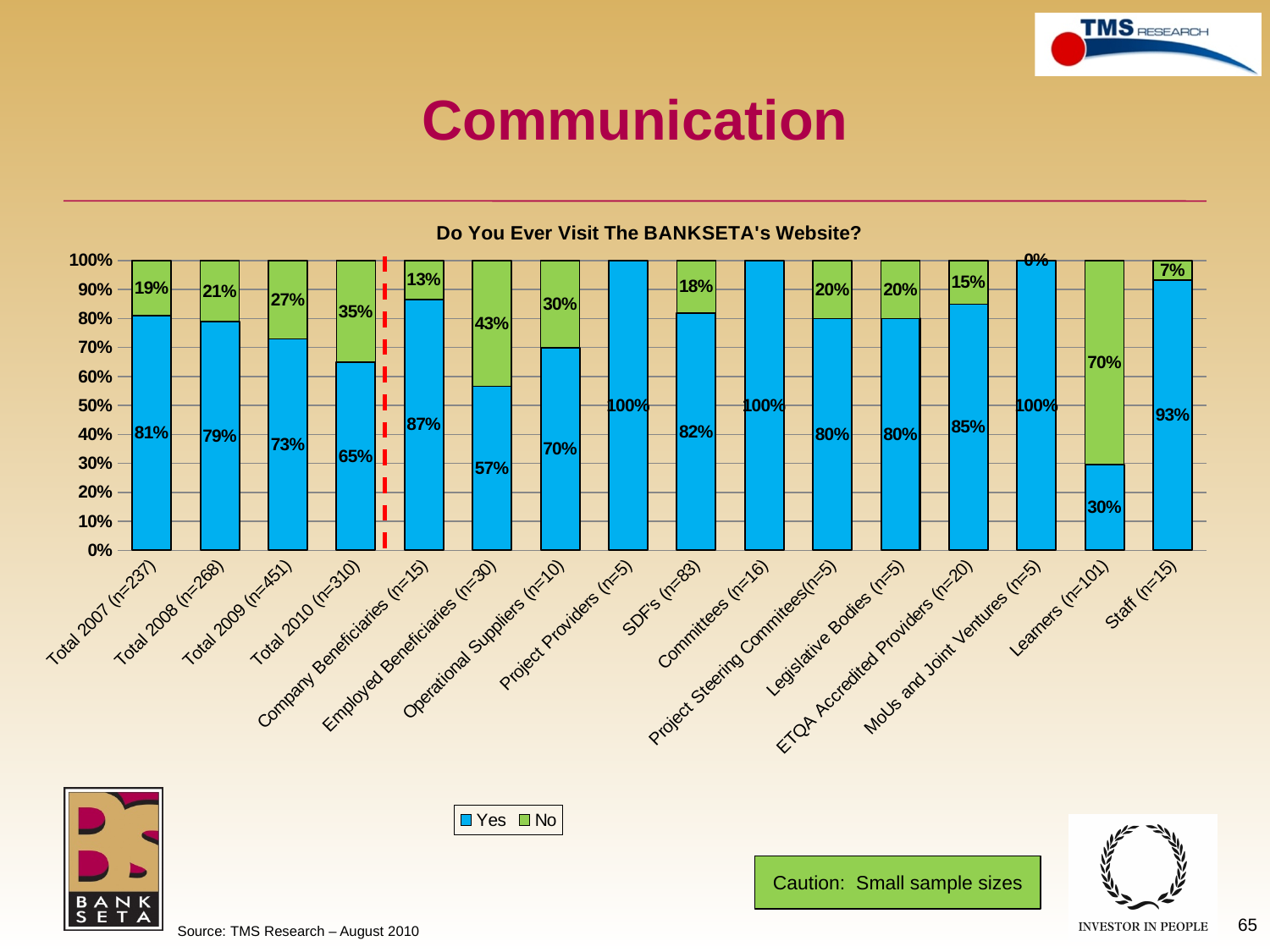
Does the Yes percentage rise or fall across the Total 2007 to Total 2010 categories? Fall What is the Yes percentage for Staff (n=15)? 93% What is the title of the chart? Do You Ever Visit The BANKSETA's Website? What percentage of Learners (n=101) answered Yes to visiting the BANKSETA website? 30% How many categories are shown on the x axis of the chart? 16 How many series does the legend list? 2 What is the No percentage for Total 2010 (n=310)? 35% What is the difference between the Yes percentages for Total 2007 (n=237) and Total 2010 (n=310)? 16% Which category has the highest No percentage? Learners (n=101) What kind of chart is shown on the slide? Stacked bar chart Which has a higher Yes percentage, Employed Beneficiaries (n=30) or Company Beneficiaries (n=15)? Company Beneficiaries (n=15) Which category has the lowest Yes percentage? Learners (n=101)